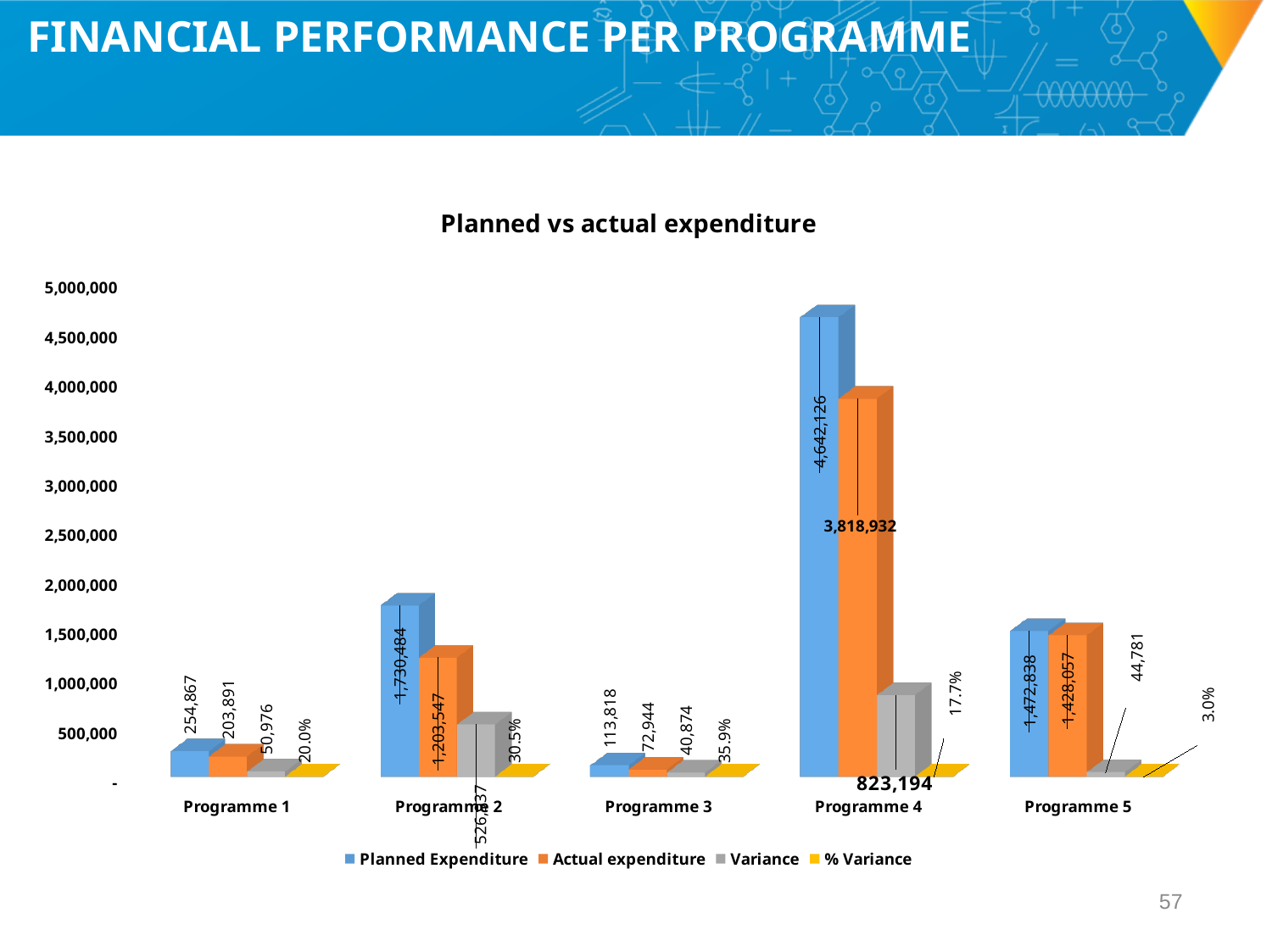
What is the % Variance for Programme 3? 35.9% What is the difference between Planned Expenditure and Actual expenditure for Programme 1? 50,976 Is the Planned Expenditure for Programme 4 greater or less than 4,500,000? greater What is the Planned Expenditure for Programme 4? 4,642,126 Which programme has the highest Planned Expenditure? Programme 4 Which programme has the lowest Actual expenditure? Programme 3 Which is larger, the Actual expenditure for Programme 5 or the Actual expenditure for Programme 2? Programme 5 How many series does the legend list? 4 What kind of chart is shown on the slide? Bar chart What is the Variance for Programme 5? 44,781 How many programmes are shown on the x axis? 5 What is the Actual expenditure for Programme 2? 1,203,547